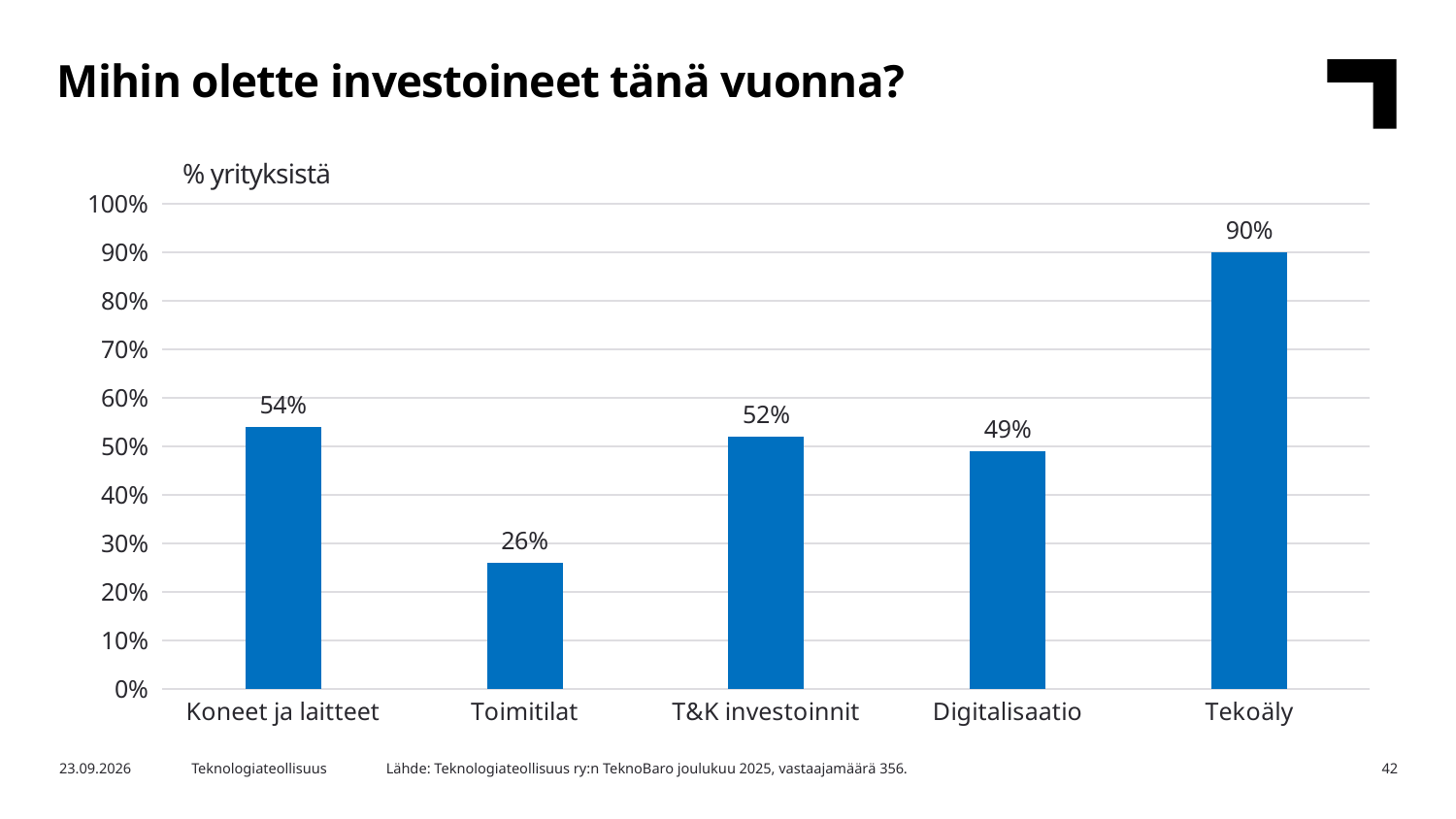
What is the value for Tekoäly? 90% What is the difference between the values for Koneet ja laitteet and T&K investoinnit? 2% What kind of chart is shown on the slide? Bar chart What is the value for Digitalisaatio? 49% Which is larger, the value for T&K investoinnit or the value for Digitalisaatio? T&K investoinnit What is the value for Toimitilat? 26% Which category has the highest value? Tekoäly What is the difference between the values for Tekoäly and Toimitilat? 64% How many categories are shown on the x axis? 5 What is the value for Koneet ja laitteet? 54% Which category has the lowest value? Toimitilat What is the title of the chart? Mihin olette investoineet tänä vuonna?